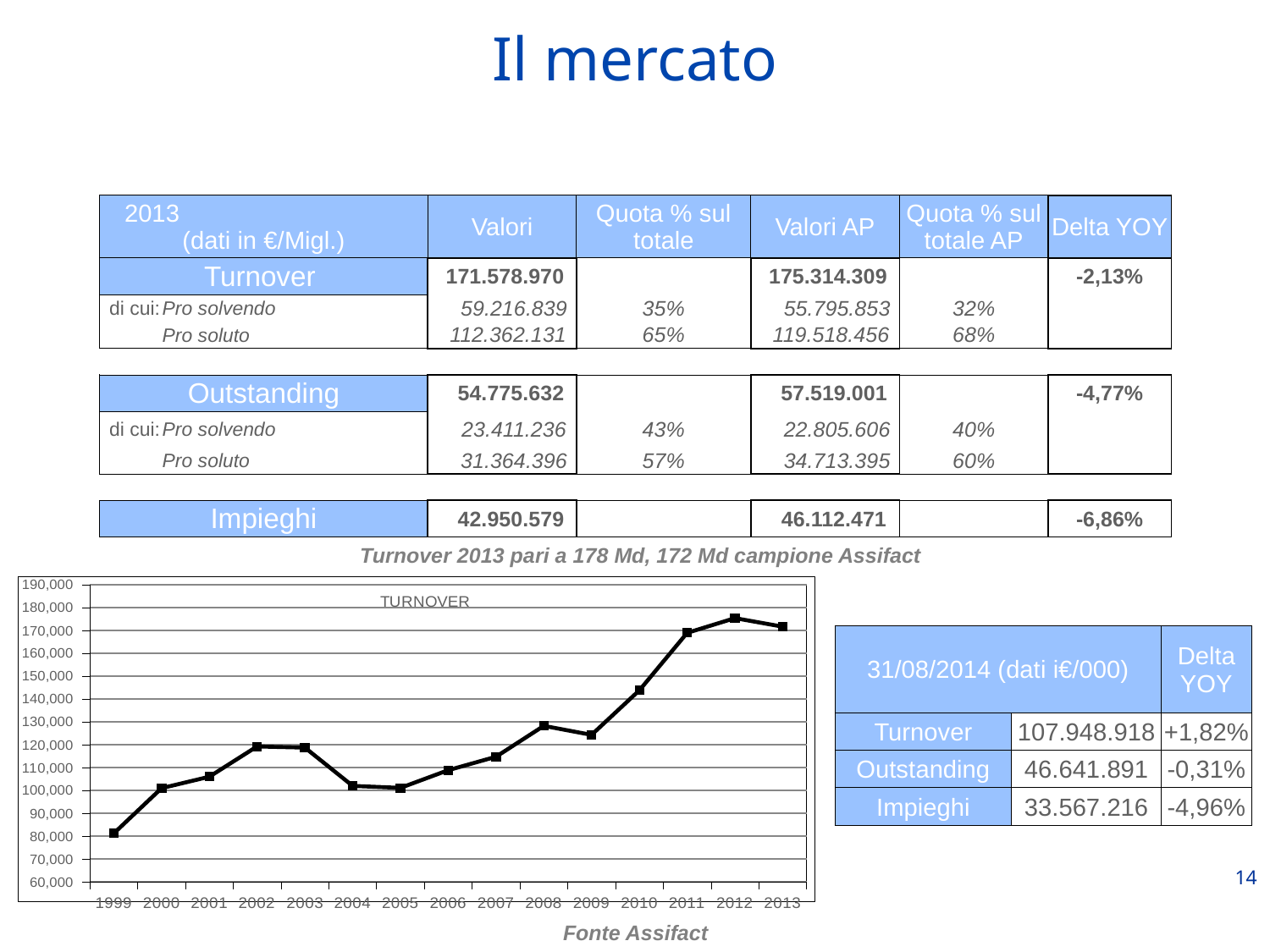
In the TURNOVER chart, is the value for 2009 greater or less than 130,000? less In the TURNOVER chart, which year has the highest value? 2012 In the TURNOVER chart, is the value for 2011 greater or less than 160,000? greater How many years are plotted on the x axis of the TURNOVER chart? 15 In the TURNOVER chart, do the values rise or fall from 2009 to 2012? rise In the TURNOVER chart, is the value for 1999 greater or less than 90,000? less What is the title of the chart on the slide? TURNOVER In the TURNOVER chart, which year has the larger value, 2002 or 2004? 2002 In the TURNOVER chart, do the values rise or fall from 2003 to 2005? fall In the TURNOVER chart, which year has the lowest value? 1999 What kind of chart is shown at the bottom left of the slide? line chart